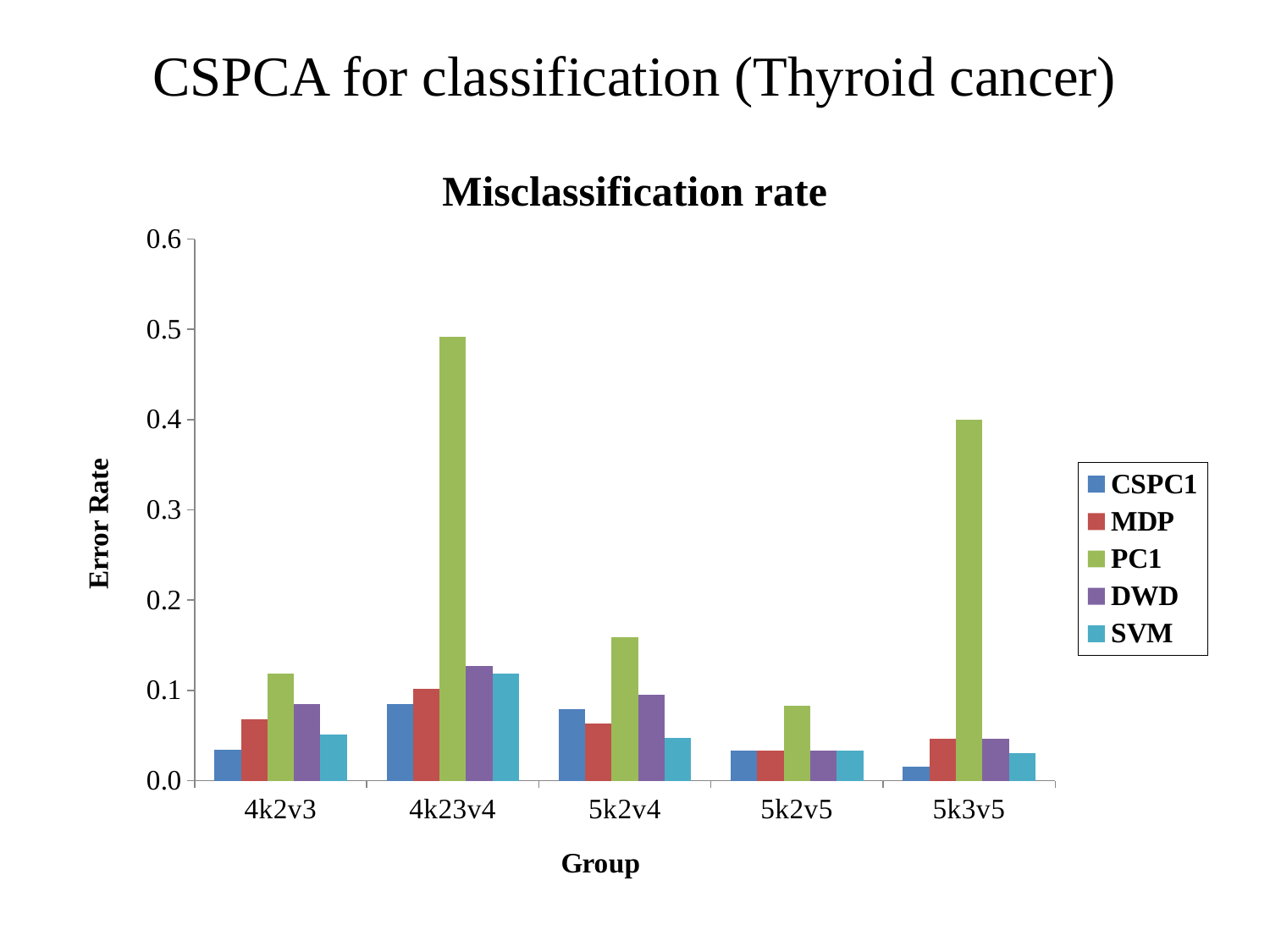
Is the CSPC1 value for 4k2v3 greater or less than 0.1? less How many groups are shown on the x axis? 5 Which is larger in the 5k2v4 group, the CSPC1 value or the PC1 value? PC1 What kind of chart is shown on the slide? bar chart Which is larger in the 4k2v3 group, the CSPC1 value or the MDP value? MDP How many series does the legend list? 5 What is the title of the chart? Misclassification rate In which group does PC1 reach its highest error rate? 4k23v4 Which series has the lowest error rate in the 5k3v5 group? CSPC1 Is the PC1 value for 4k23v4 greater or less than 0.4? greater Which series has the highest error rate in the 4k23v4 group? PC1 Is the PC1 value for 5k2v4 greater or less than 0.2? less